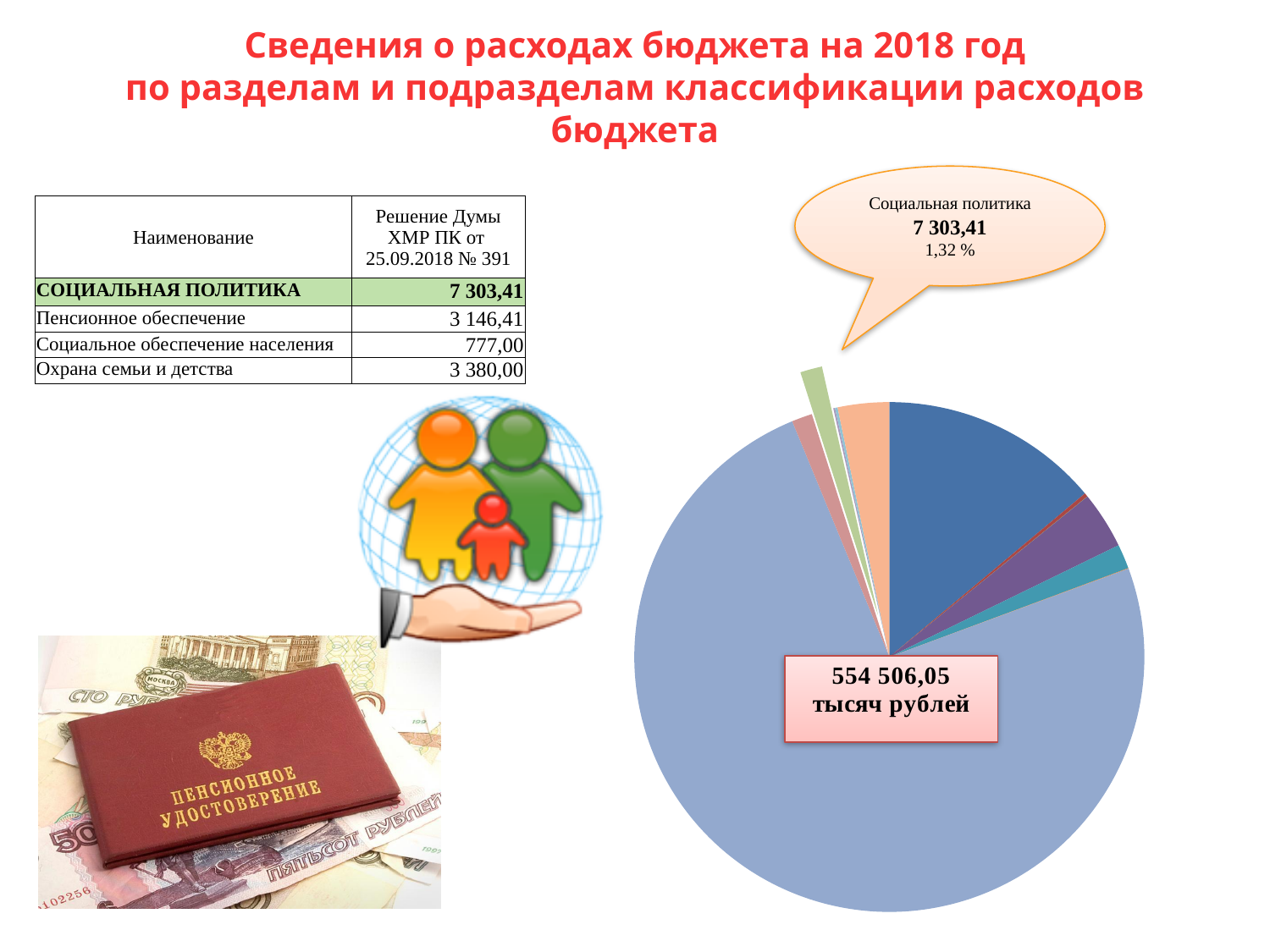
What share of the pie does Социальная политика represent, according to the callout? 1,32 % Which category is named in the callout pointing to the exploded slice of the pie chart? Социальная политика Is the exploded Социальная политика slice larger or smaller than the largest slice of the pie? smaller Is the share of the pie for Социальная политика greater or less than 50%? less What kind of chart is shown on the right side of the slide? pie chart What total amount is shown in the box at the centre of the pie chart? 554 506,05 тысяч рублей Does the pie chart have a legend listing its slices? No According to the callout on the pie chart, what is the value for Социальная политика? 7 303,41